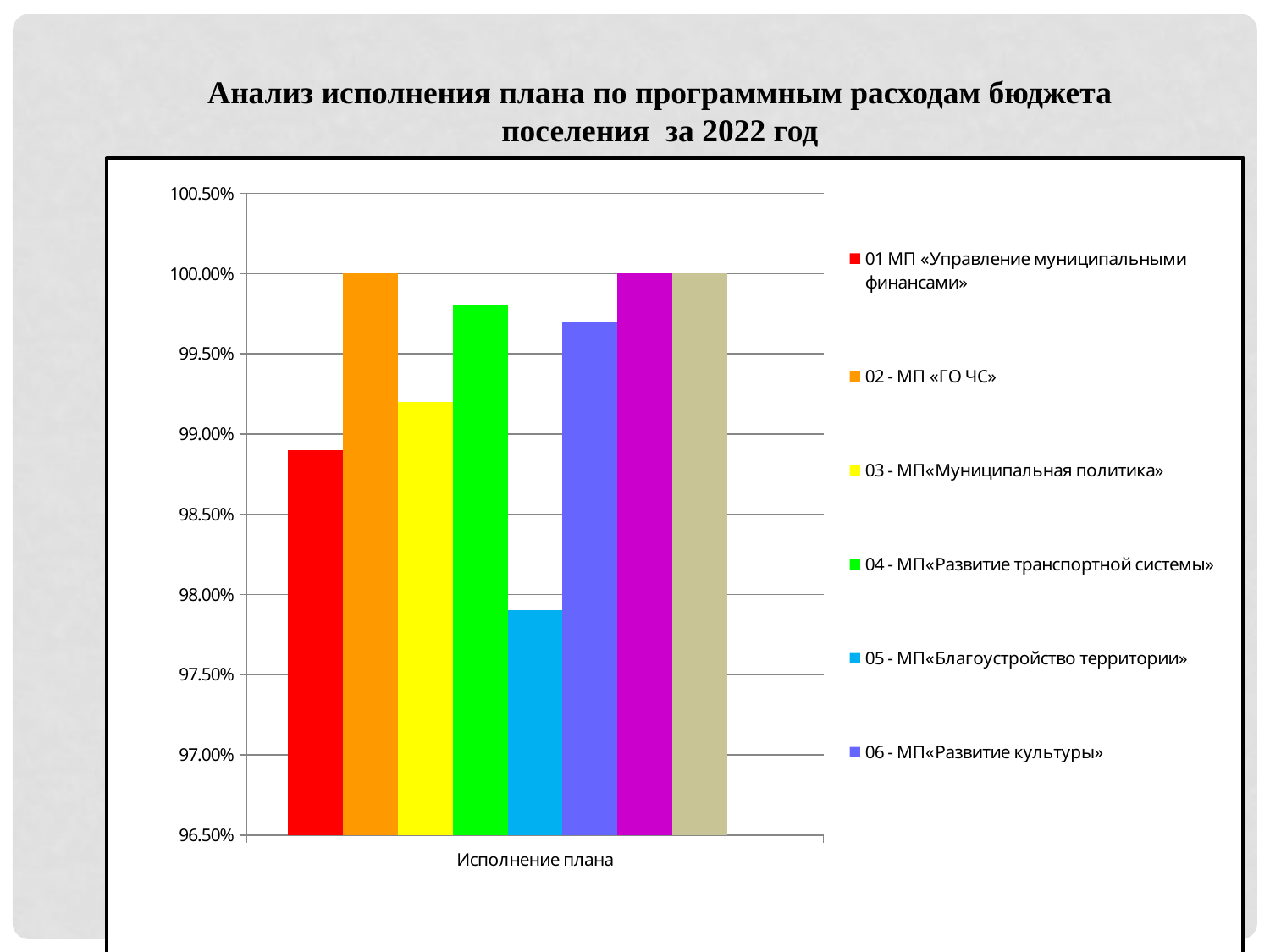
What is the value for 02 - МП «ГО ЧС»? 100.00% Is the value for 01 МП «Управление муниципальными финансами» greater or less than 99.00%? less Which is larger: the value for 01 МП «Управление муниципальными финансами» or for 05 - МП«Благоустройство территории»? 01 МП «Управление муниципальными финансами» How many bars are plotted in the chart? 8 What is the label shown on the x axis of the chart? Исполнение плана Is the value for 05 - МП«Благоустройство территории» greater or less than 98.00%? less What kind of chart is shown on the slide? bar chart Which is larger: the value for 04 - МП«Развитие транспортной системы» or for 03 - МП«Муниципальная политика»? 04 - МП«Развитие транспортной системы» Which legend entry has the lowest value? 05 - МП«Благоустройство территории» How many series does the legend list? 6 Is the value for 04 - МП«Развитие транспортной системы» greater or less than 99.50%? greater